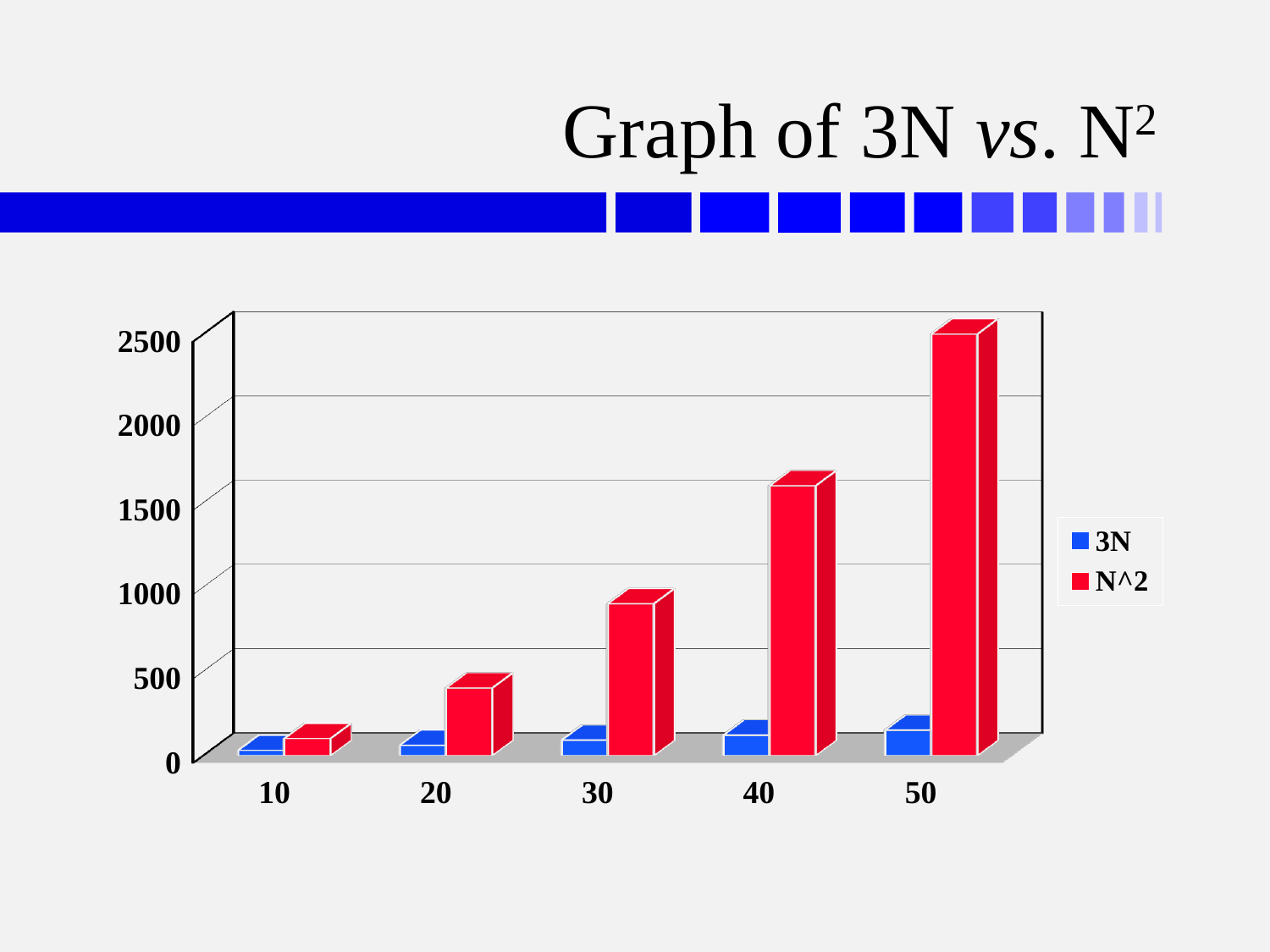
Is the value of N^2 at category 30 greater or less than 1000? less At category 40, which series has the larger value, 3N or N^2? N^2 Is the value of 3N at category 50 greater or less than 500? less Do the N^2 values rise or fall as the category increases from 10 to 50? rise How many categories are shown on the x axis? 5 Which colour represents the 3N series in the legend? blue How many series does the legend list? 2 What kind of chart is shown on the slide? bar chart Is the value of N^2 at category 20 greater or less than 500? less For which category is the N^2 bar the highest? 50 For which category is the N^2 bar the lowest? 10